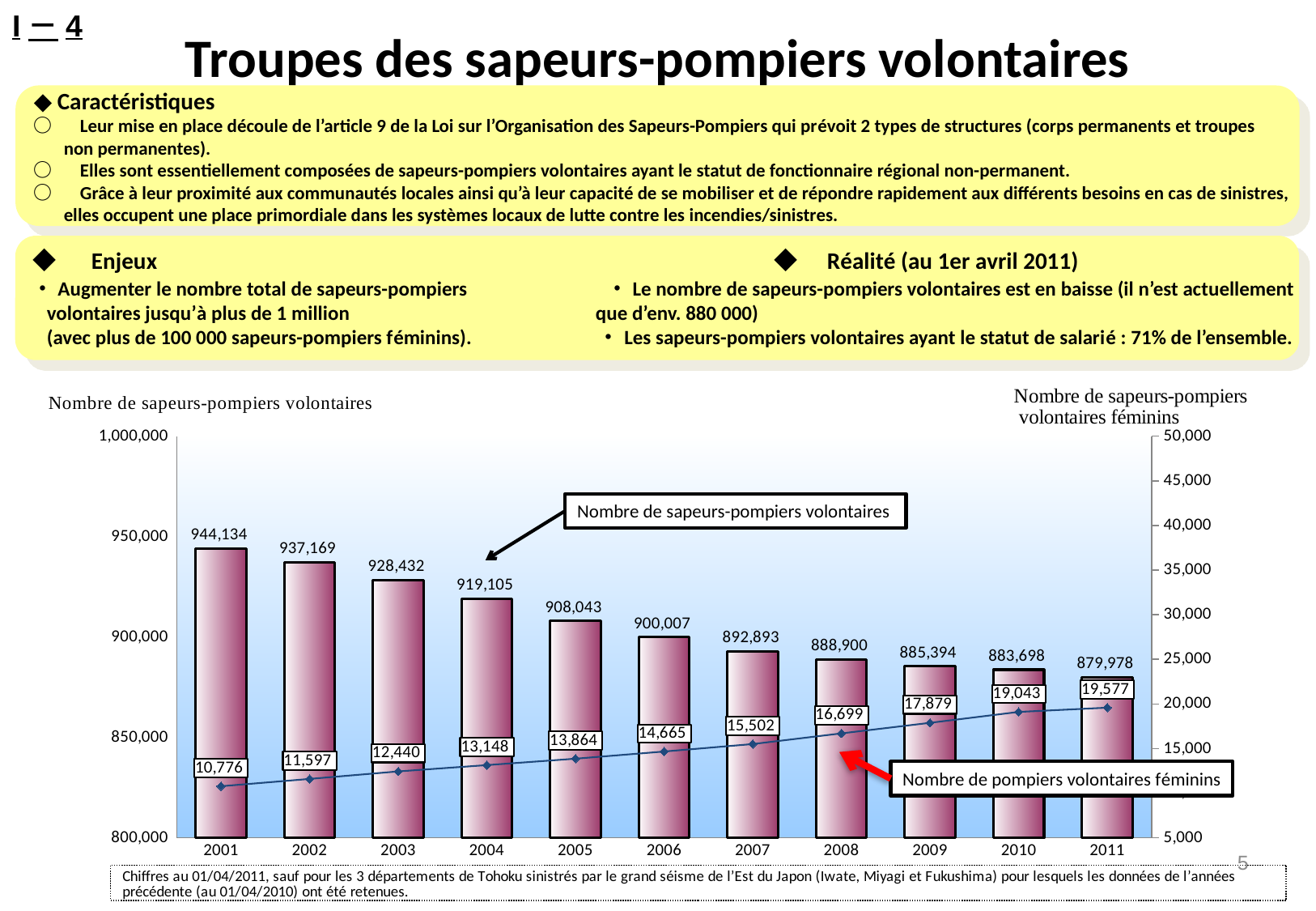
Which year has the lowest number of female volunteer firefighters (line)? 2001 What is the difference between the number of volunteer firefighters in 2001 and in 2011? 64,156 Is the number of volunteer firefighters in 2006 greater or less than 950,000? less What is the number of volunteer firefighters (bar) for 2001? 944,134 How many years are shown on the x axis of the chart? 11 What is the label of the right-hand vertical axis of the chart? Nombre de sapeurs-pompiers volontaires féminins How does the number of volunteer firefighters (bars) change from 2001 to 2011? It falls What is the number of volunteer firefighters (bar) for 2011? 879,978 What is the number of female volunteer firefighters (line) for 2011? 19,577 Which year has the highest number of volunteer firefighters (bars)? 2001 What is the number of female volunteer firefighters (line) for 2008? 16,699 Which is larger: the number of female volunteer firefighters in 2005 or in 2009? 2009